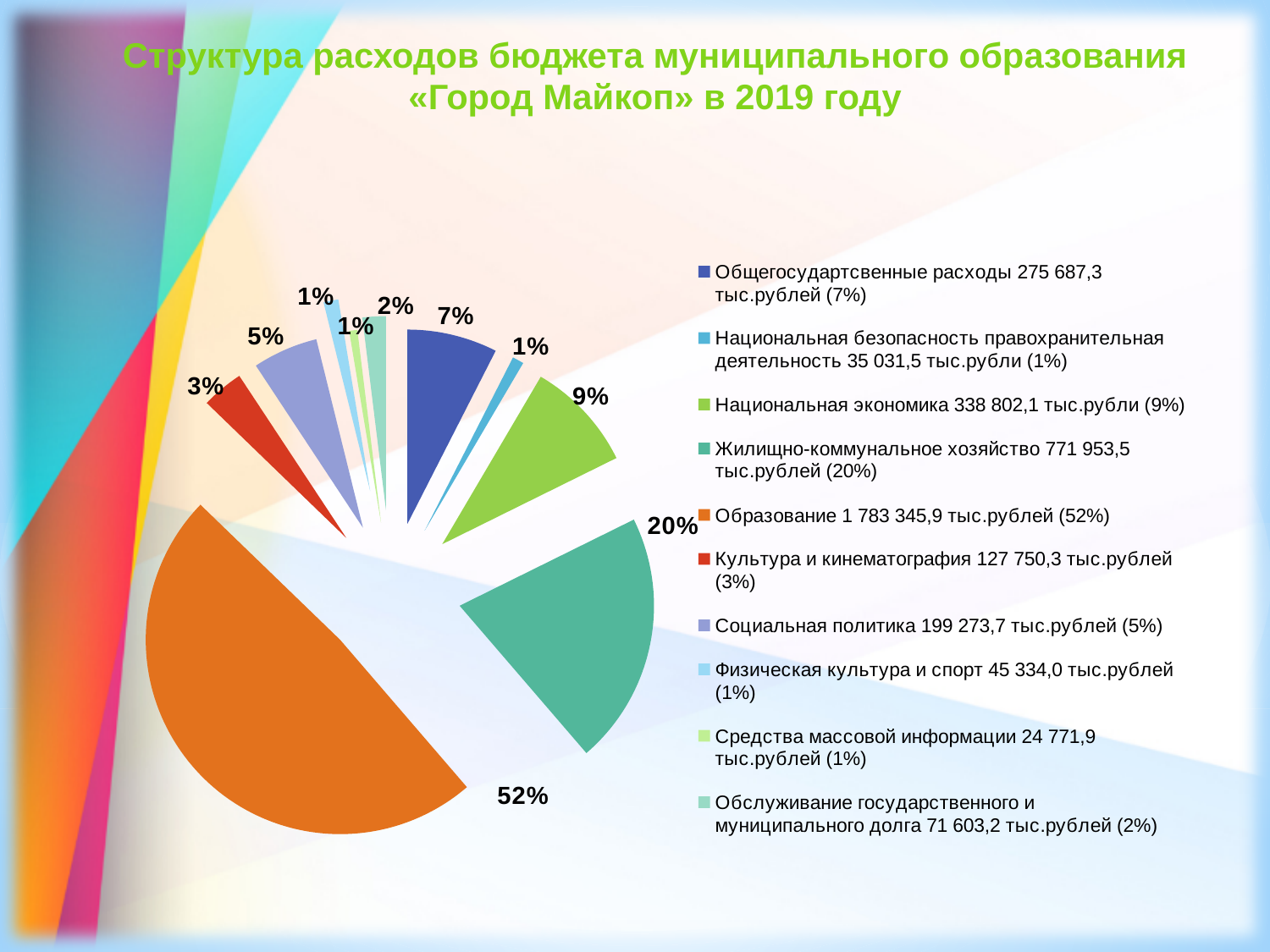
What is the difference in percentage points between the Образование slice and the Жилищно-коммунальное хозяйство slice? 32 What share of the pie does Жилищно-коммунальное хозяйство take? 20% Which is larger, the slice for Образование or the slice for Жилищно-коммунальное хозяйство? Образование What share of the pie does Образование take? 52% What share of the pie does Национальная экономика take? 9% According to the legend, what is the amount for Культура и кинематография? 127 750,3 тыс.рублей What kind of chart is shown on the slide? pie chart How many slices does the pie chart have? 10 What is the title of the chart on the slide? Структура расходов бюджета муниципального образования «Город Майкоп» в 2019 году Which category has the largest slice of the pie? Образование